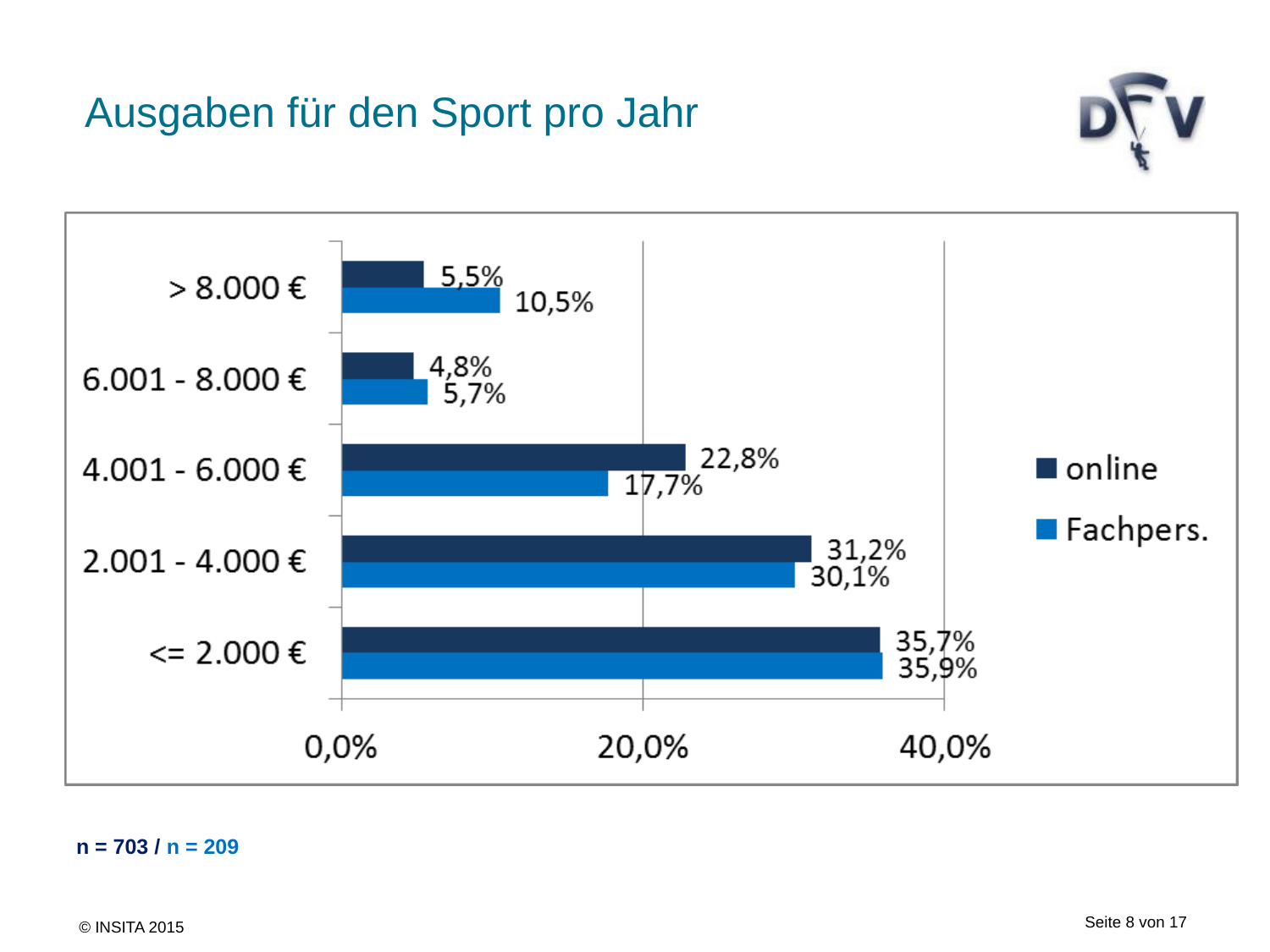
What is the difference between the "Fachpers." and "online" values in the "> 8.000 €" category? 5,0% Which category has the lowest value for the "online" series? 6.001 - 8.000 € What is the value for "Fachpers." in the "> 8.000 €" category? 10,5% How many expenditure categories are shown on the chart? 5 In the "4.001 - 6.000 €" category, which series has the larger value, "online" or "Fachpers."? online What is the title of the slide containing the chart? Ausgaben für den Sport pro Jahr Which category has the highest value for the "Fachpers." series? <= 2.000 € What is the value for "online" in the "<= 2.000 €" category? 35,7% How many series does the legend list? 2 Is the "online" value for "2.001 - 4.000 €" greater or less than 20,0%? greater What is the value for "online" in the "4.001 - 6.000 €" category? 22,8% What kind of chart is shown on the slide? Bar chart